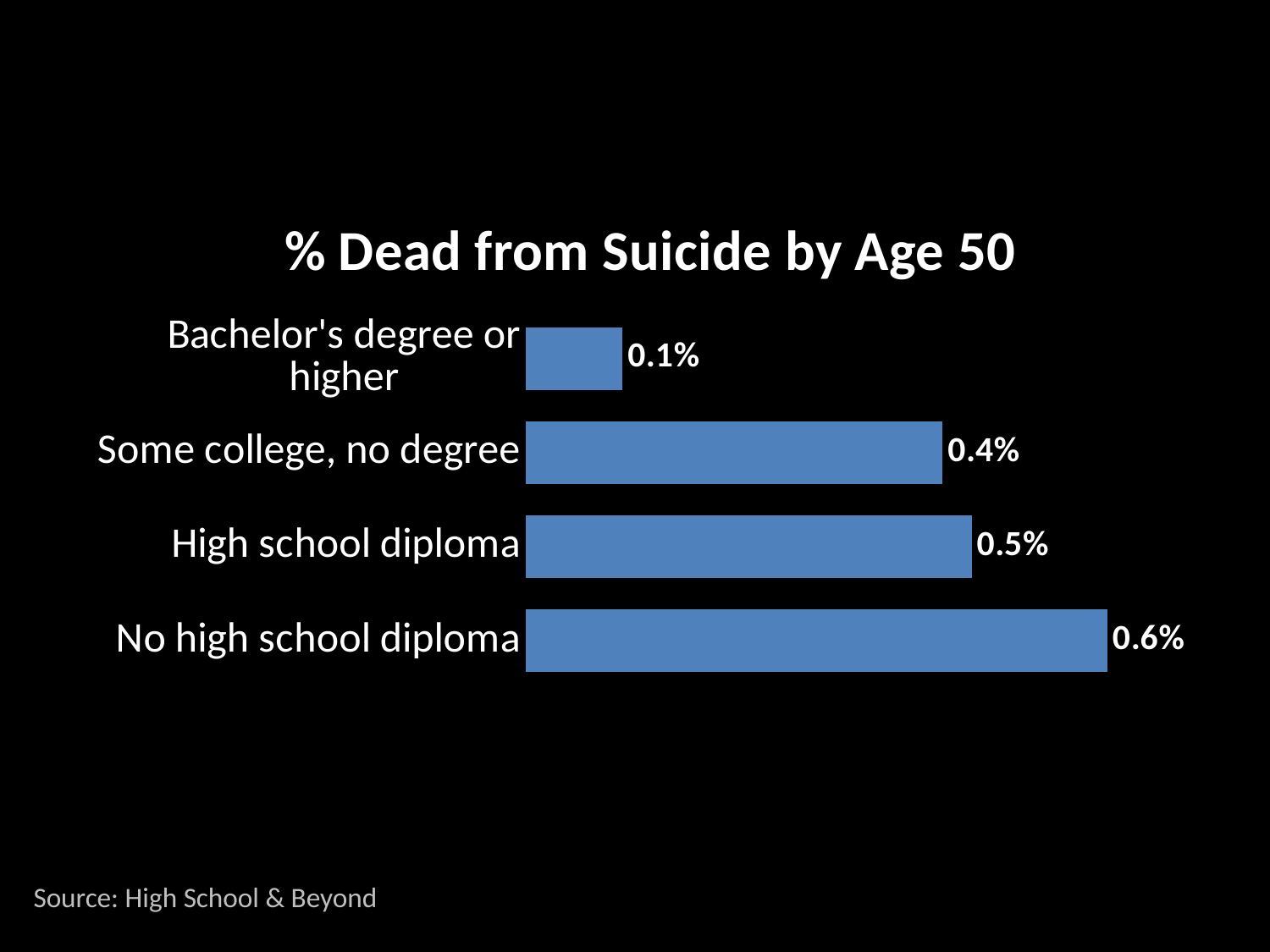
What kind of chart is shown on the slide? Bar chart Which category has the lowest value? Bachelor's degree or higher What is the value for High school diploma? 0.5% What is the value for No high school diploma? 0.6% Which category has the highest value? No high school diploma What is the value for Bachelor's degree or higher? 0.1% What is the title of the chart? % Dead from Suicide by Age 50 What is the value for Some college, no degree? 0.4% What is the difference between the values for High school diploma and Some college, no degree? 0.1% How many categories are shown in the chart? 4 Which is larger, the value for Some college, no degree or the value for High school diploma? High school diploma What is the difference between the values for No high school diploma and Bachelor's degree or higher? 0.5%